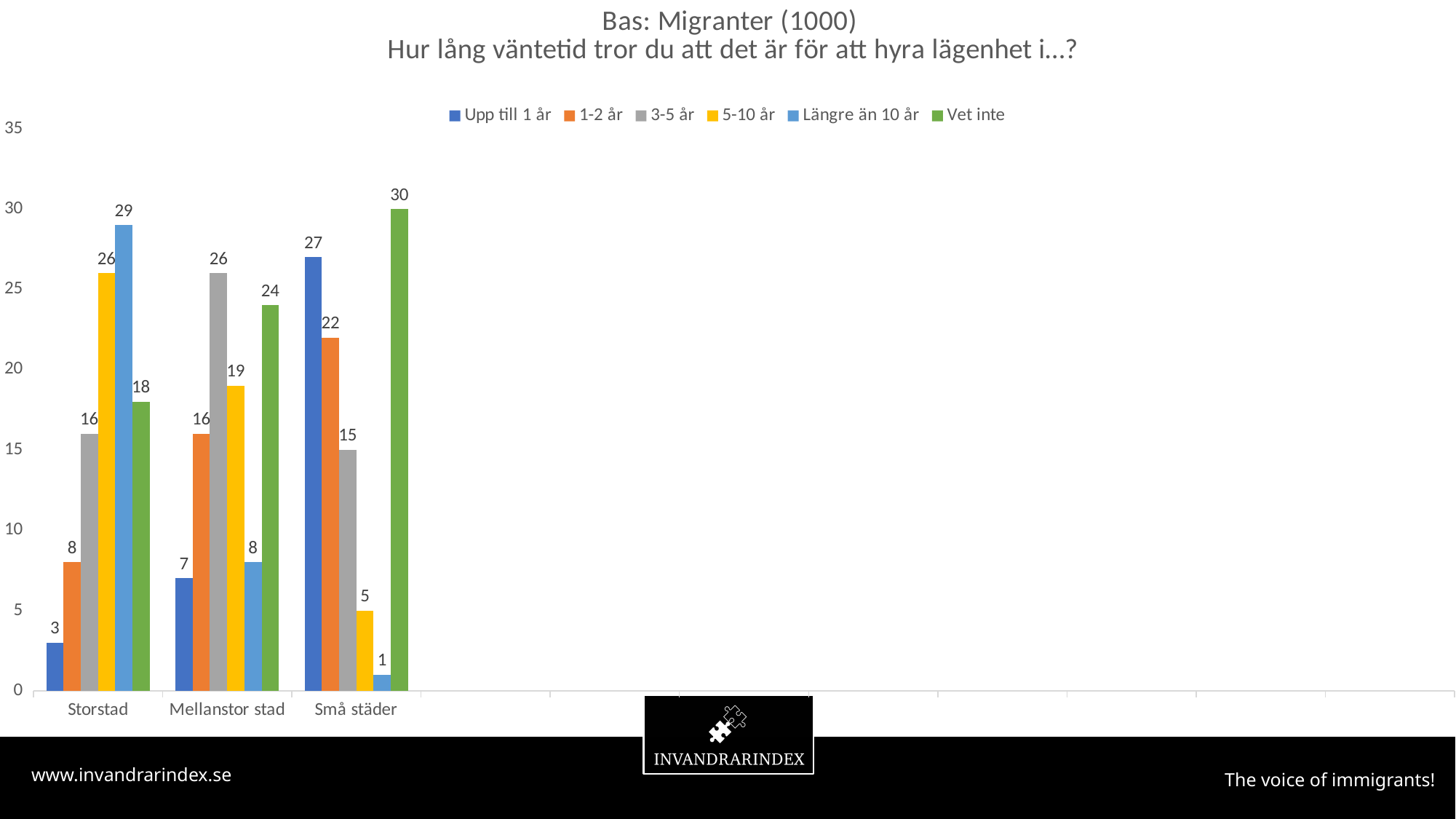
What is the difference between the 'Upp till 1 år' values for Små städer and Storstad? 24 How many categories are shown on the x axis? 3 How many series does the legend list? 6 What is the value for '3-5 år' in the Mellanstor stad category? 26 Which series has the lowest value in the Små städer category? Längre än 10 år What kind of chart is shown on the slide? Bar chart What is the value for 'Vet inte' in the Små städer category? 30 Which series has the highest value in the Mellanstor stad category? 3-5 år Which is larger: the '5-10 år' value for Storstad or for Mellanstor stad? Storstad Is the value for '1-2 år' in Små städer greater or less than 20? greater What is the value for 'Längre än 10 år' in the Storstad category? 29 What is the value for 'Upp till 1 år' in the Storstad category? 3